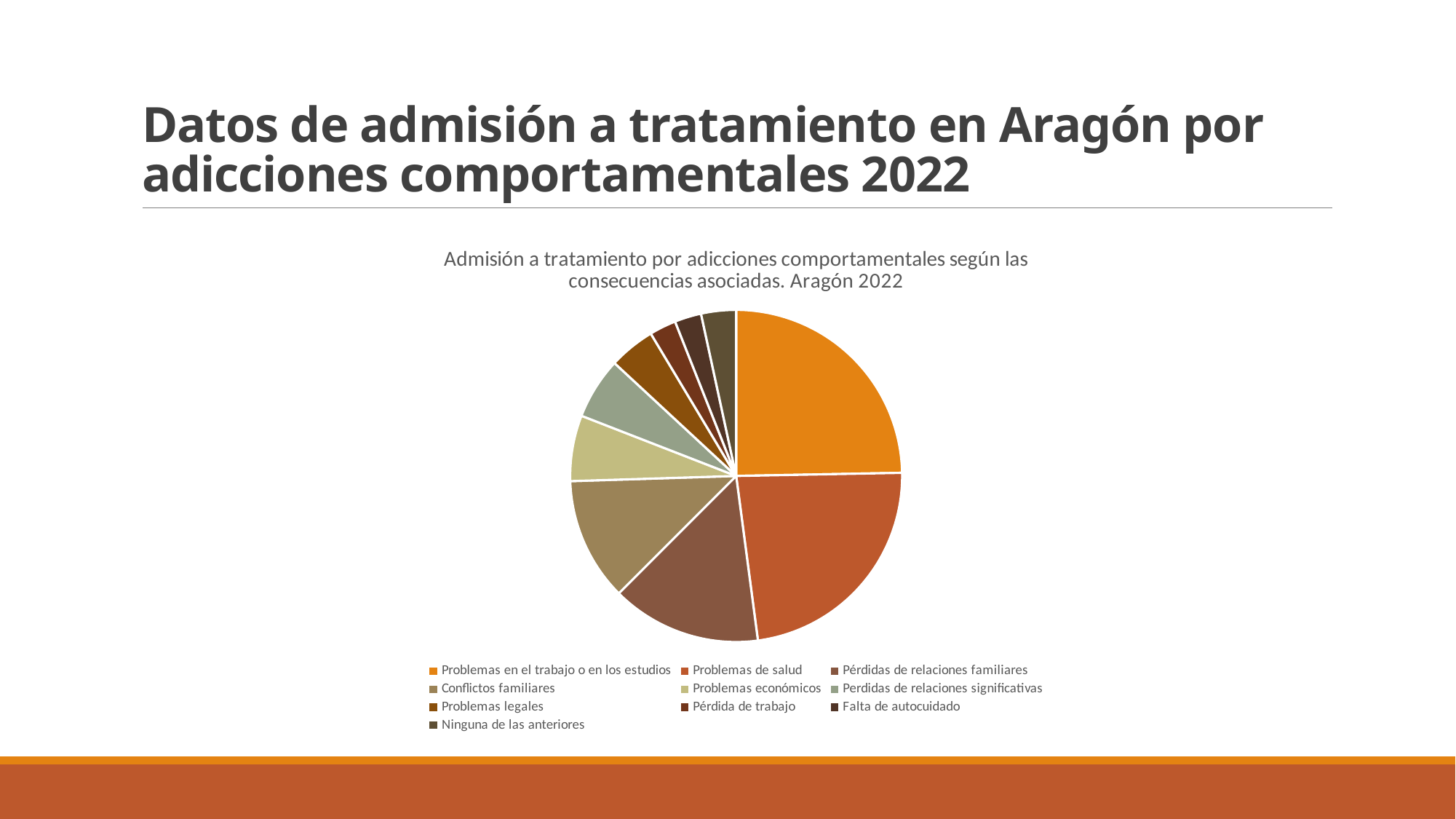
Which slice is larger: "Problemas de salud" or "Pérdida de trabajo"? Problemas de salud Which legend entry is listed last in the chart's legend? Ninguna de las anteriores What colour is the slice for "Problemas en el trabajo o en los estudios"? Orange Which slice is larger: "Problemas de salud" or "Conflictos familiares"? Problemas de salud What kind of chart is shown on the slide? Pie chart Which slice is larger: "Problemas en el trabajo o en los estudios" or "Problemas económicos"? Problemas en el trabajo o en los estudios How many categories (slices) does the pie chart have? 10 What is the title of the chart? Admisión a tratamiento por adicciones comportamentales según las consecuencias asociadas. Aragón 2022